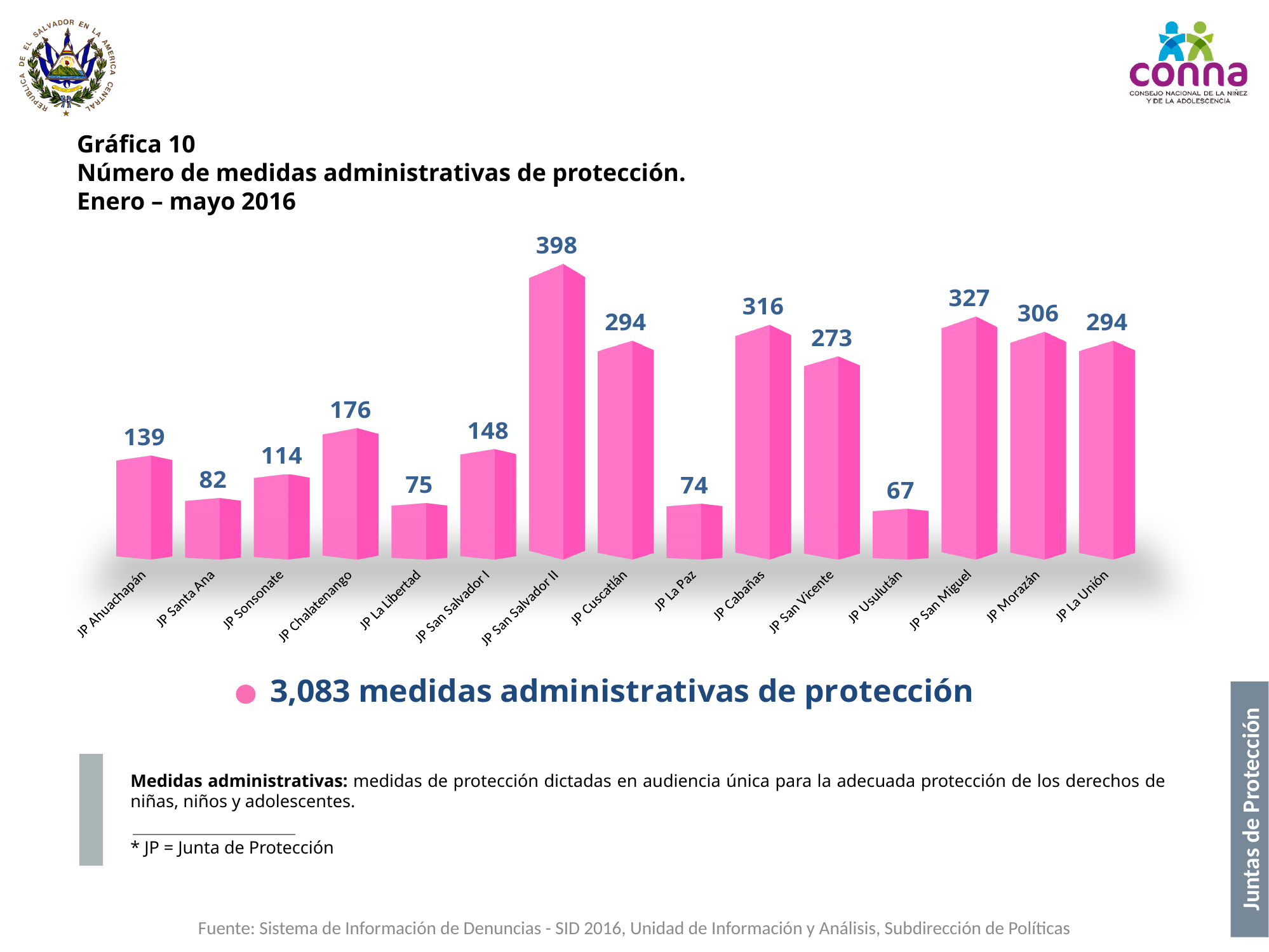
What total number of medidas administrativas de protección is stated in the legend below the chart? 3,083 What is the value for JP San Salvador II? 398 What colour are the bars in the chart? pink Which is larger, the value for JP Cabañas or the value for JP San Vicente? JP Cabañas What is the value for JP Chalatenango? 176 What kind of chart is this? bar chart What is the value for JP Usulután? 67 Which category has the highest value? JP San Salvador II What is the difference between the values for JP San Miguel and JP Morazán? 21 Which category has the lowest value? JP Usulután How many categories are shown on the x axis? 15 What is the difference between the values for JP Ahuachapán and JP Santa Ana? 57